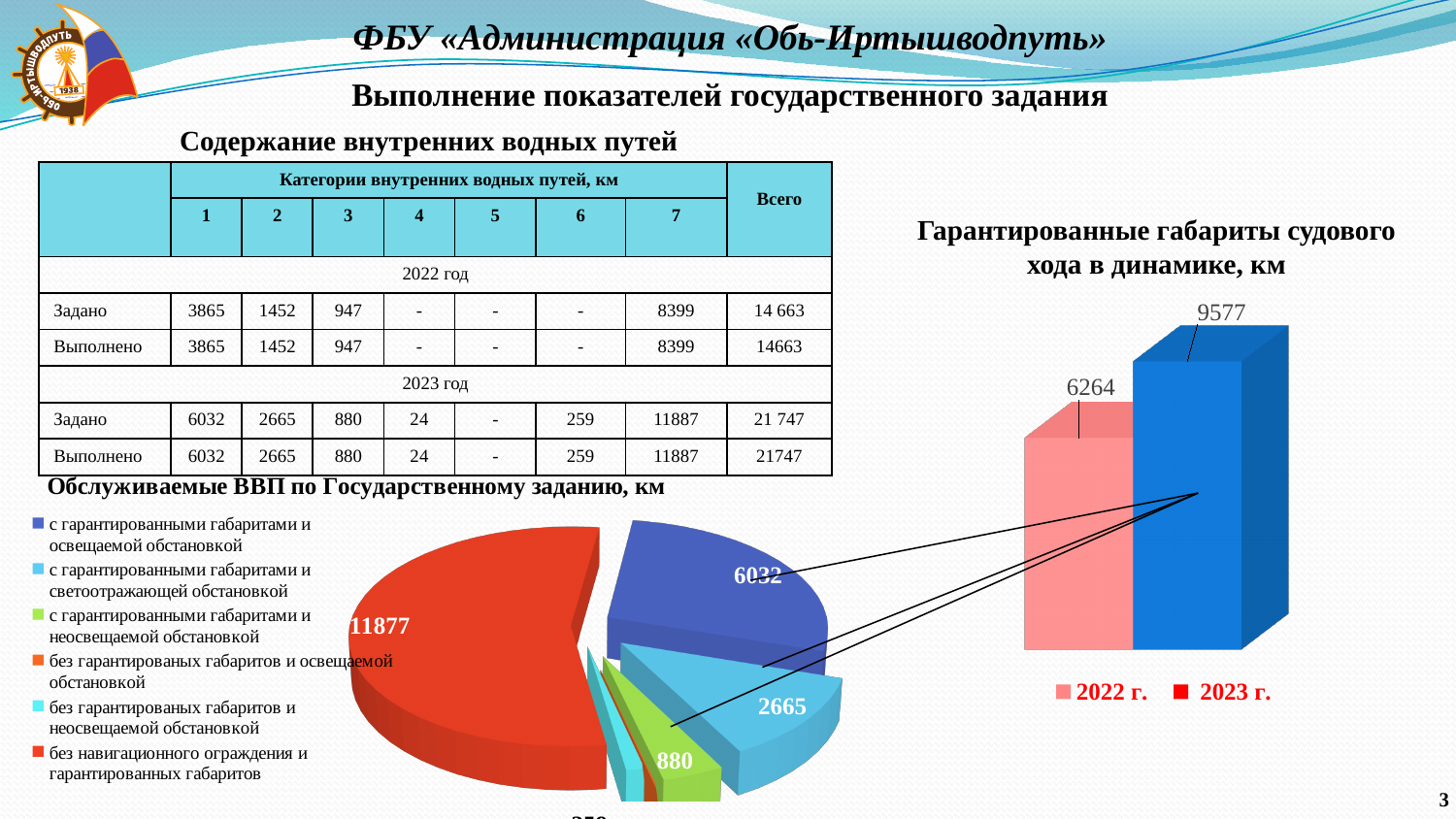
What kind of chart is 'Обслуживаемые ВВП по Государственному заданию, км'? pie chart In the bar chart 'Гарантированные габариты судового хода в динамике, км', by how much does the 2023 г. value exceed the 2022 г. value? 3313 In the pie chart 'Обслуживаемые ВВП по Государственному заданию, км', what is the value of the largest slice? 11877 In the pie chart 'Обслуживаемые ВВП по Государственному заданию, км', what is the value for 'с гарантированными габаритами и освещаемой обстановкой'? 6032 In the bar chart 'Гарантированные габариты судового хода в динамике, км', which year has the larger value, 2022 г. or 2023 г.? 2023 г. In the bar chart 'Гарантированные габариты судового хода в динамике, км', what is the value for 2022 г.? 6264 How many series does the legend of the bar chart 'Гарантированные габариты судового хода в динамике, км' list? 2 How many entries does the legend of the pie chart 'Обслуживаемые ВВП по Государственному заданию, км' list? 6 In the pie chart 'Обслуживаемые ВВП по Государственному заданию, км', what is the value for 'с гарантированными габаритами и неосвещаемой обстановкой'? 880 In the bar chart 'Гарантированные габариты судового хода в динамике, км', do the values rise or fall from 2022 г. to 2023 г.? rise What kind of chart is 'Гарантированные габариты судового хода в динамике, км'? bar chart In the bar chart 'Гарантированные габариты судового хода в динамике, км', what is the value for 2023 г.? 9577